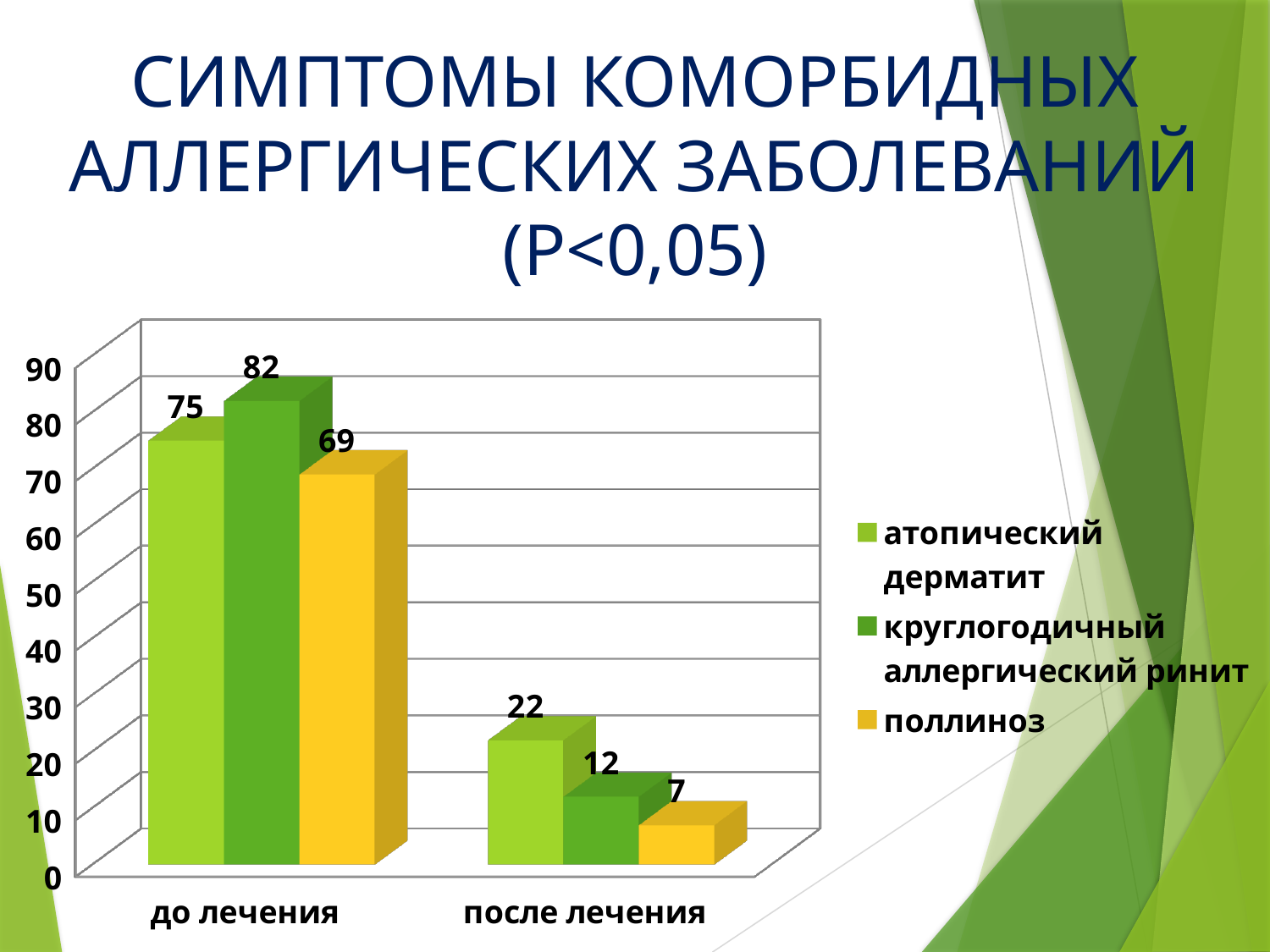
What is the value for поллиноз in the после лечения category? 7 What is the difference between the атопический дерматит values for до лечения and после лечения? 53 What is the value for круглогодичный аллергический ринит in the до лечения category? 82 Which is larger: the поллиноз value for до лечения or the атопический дерматит value for до лечения? атопический дерматит value for до лечения What kind of chart is shown on the slide? bar chart Which series has the highest value in the до лечения category? круглогодичный аллергический ринит How many series does the legend list? 3 What is the value for атопический дерматит in the после лечения category? 22 How many categories are shown on the x axis? 2 Do the values for круглогодичный аллергический ринит rise or fall from до лечения to после лечения? fall Which series has the lowest value in the после лечения category? поллиноз What colour are the bars for поллиноз? yellow